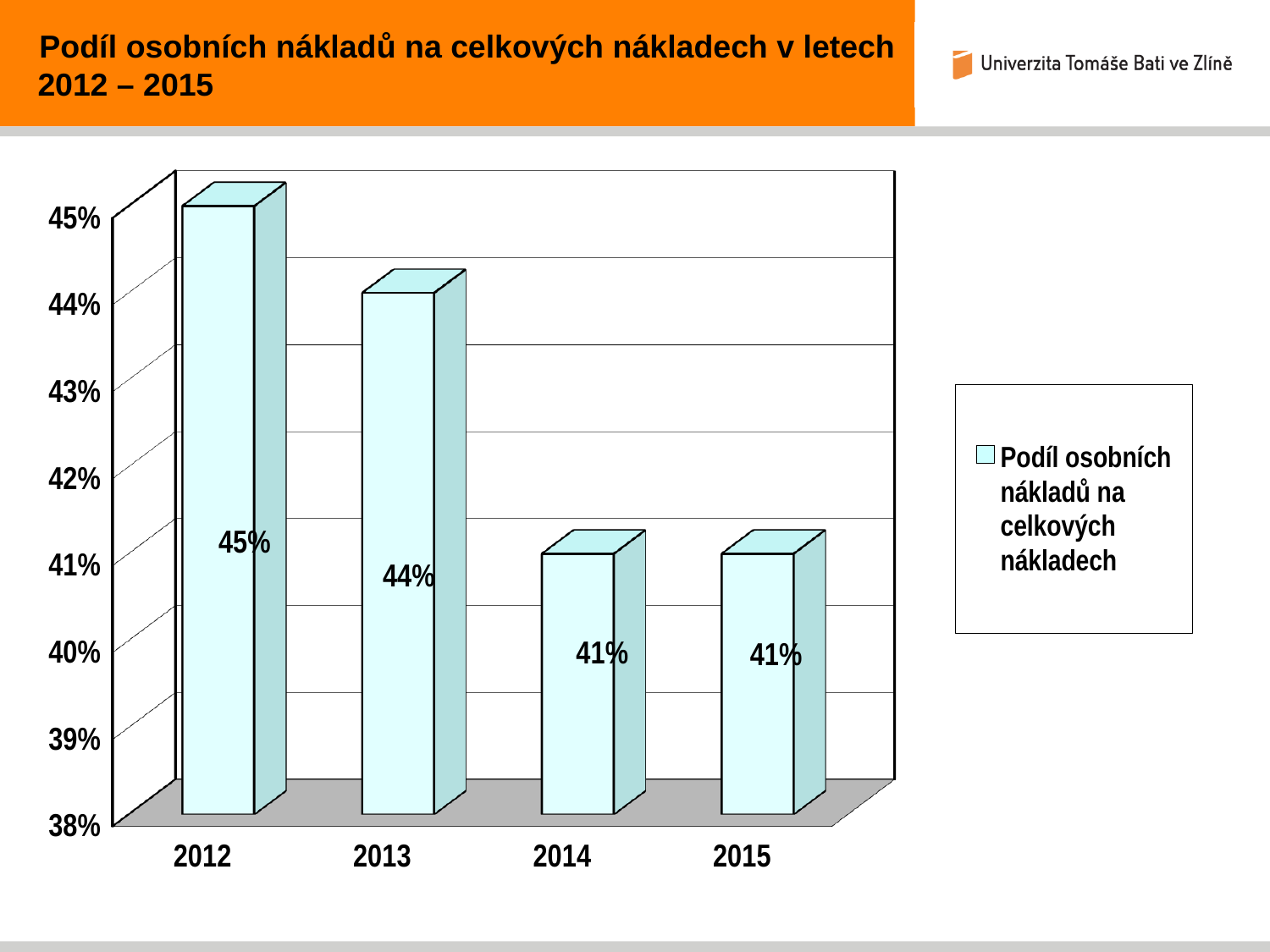
What is the difference between the values for 2012 and 2013? 1% How many years are shown on the x axis? 4 Is the value for 2013 greater or less than 42%? greater What is the value for 2014? 41% Do the values rise or fall from 2012 to 2015? fall Which is larger, the value for 2013 or the value for 2015? 2013 Which year has the highest value? 2012 What is the difference between the values for 2012 and 2014? 4% What kind of chart is shown on the slide? bar chart What is the value for 2015? 41% What is the value for 2013? 44% What is the value for 2012? 45%